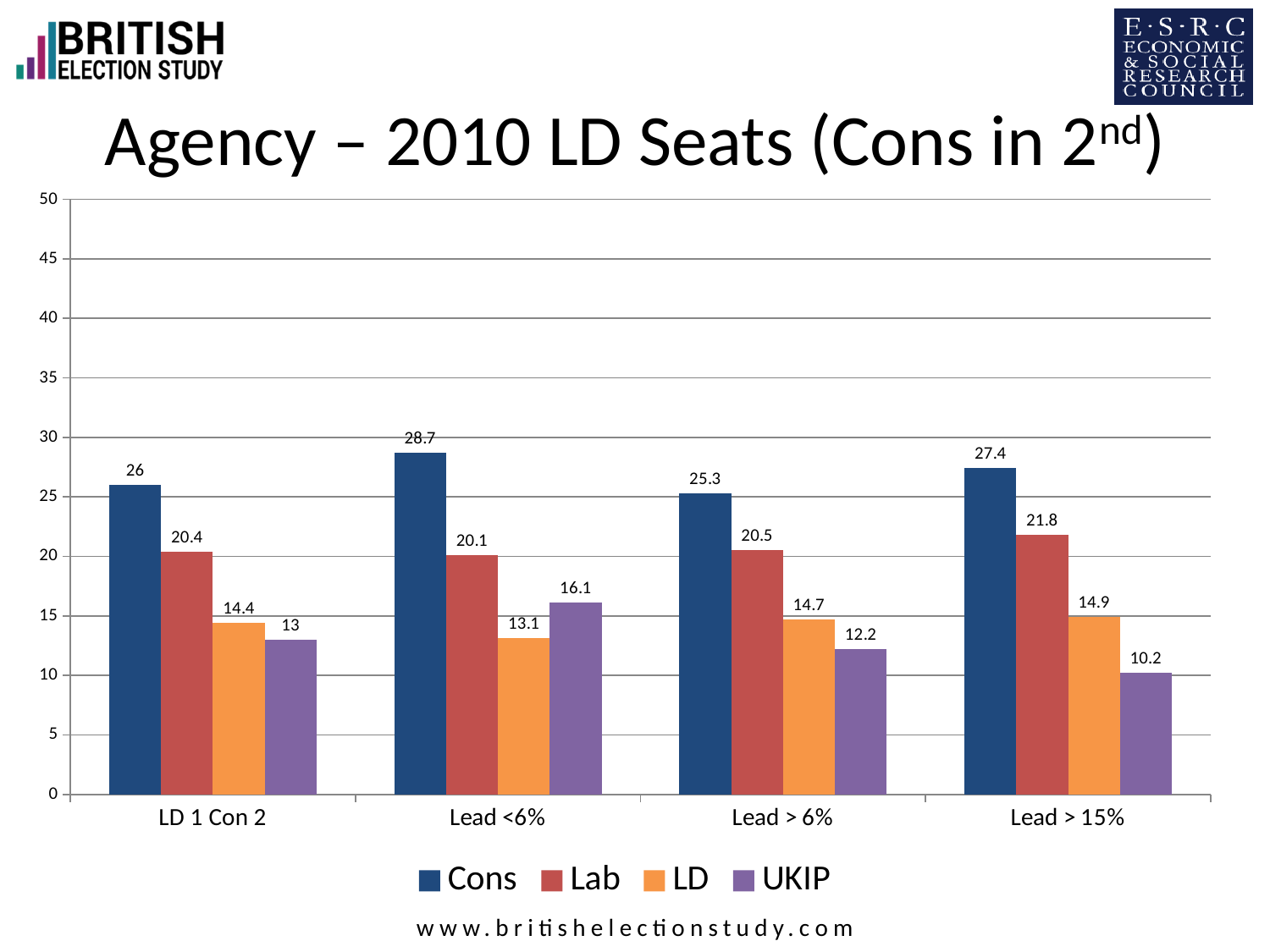
What kind of chart is shown on the slide? bar chart What is the value for UKIP in the Lead > 15% category? 10.2 What is the value for Cons in the Lead <6% category? 28.7 What is the title of the chart? Agency – 2010 LD Seats (Cons in 2nd) Which is larger in the Lead <6% category, the LD value or the UKIP value? UKIP What is the value for LD in the LD 1 Con 2 category? 14.4 In which category is the UKIP value lowest? Lead > 15% How many series does the legend list? 4 In which category is the Cons value highest? Lead <6% Is the value for Lab in the Lead > 6% category greater or less than 20? greater How many categories are shown on the x axis? 4 What is the difference between the Cons and Lab values in the Lead > 15% category? 5.6